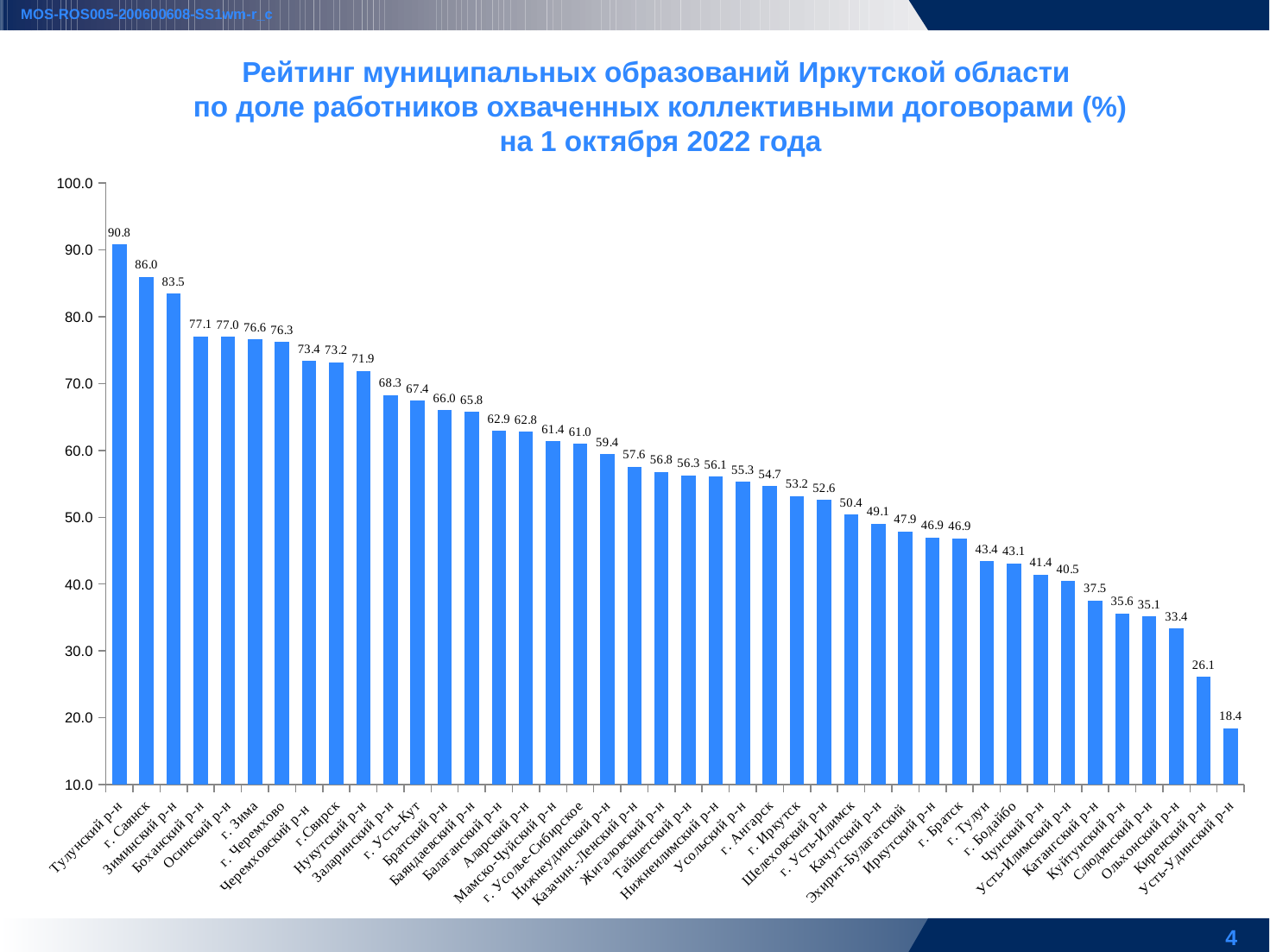
What is the difference between the values for г. Саянск and г. Ангарск? 31.3 As of what date does the chart title say the data is given? 1 октября 2022 года What kind of chart is shown on the slide? bar chart Which is larger, the value for г. Зима or the value for г. Братск? г. Зима Which municipality has the highest value? Тулунский р-н What is the value for Тулунский р-н? 90.8 Which municipality has the lowest value? Усть-Удинский р-н What is the value for г. Иркутск? 53.2 Do the values rise or fall from left to right along the x axis? fall How many municipalities are shown on the chart? 42 Is the value for Ольхонский р-н greater or less than 40.0? less What is the value for Киренский р-н? 26.1